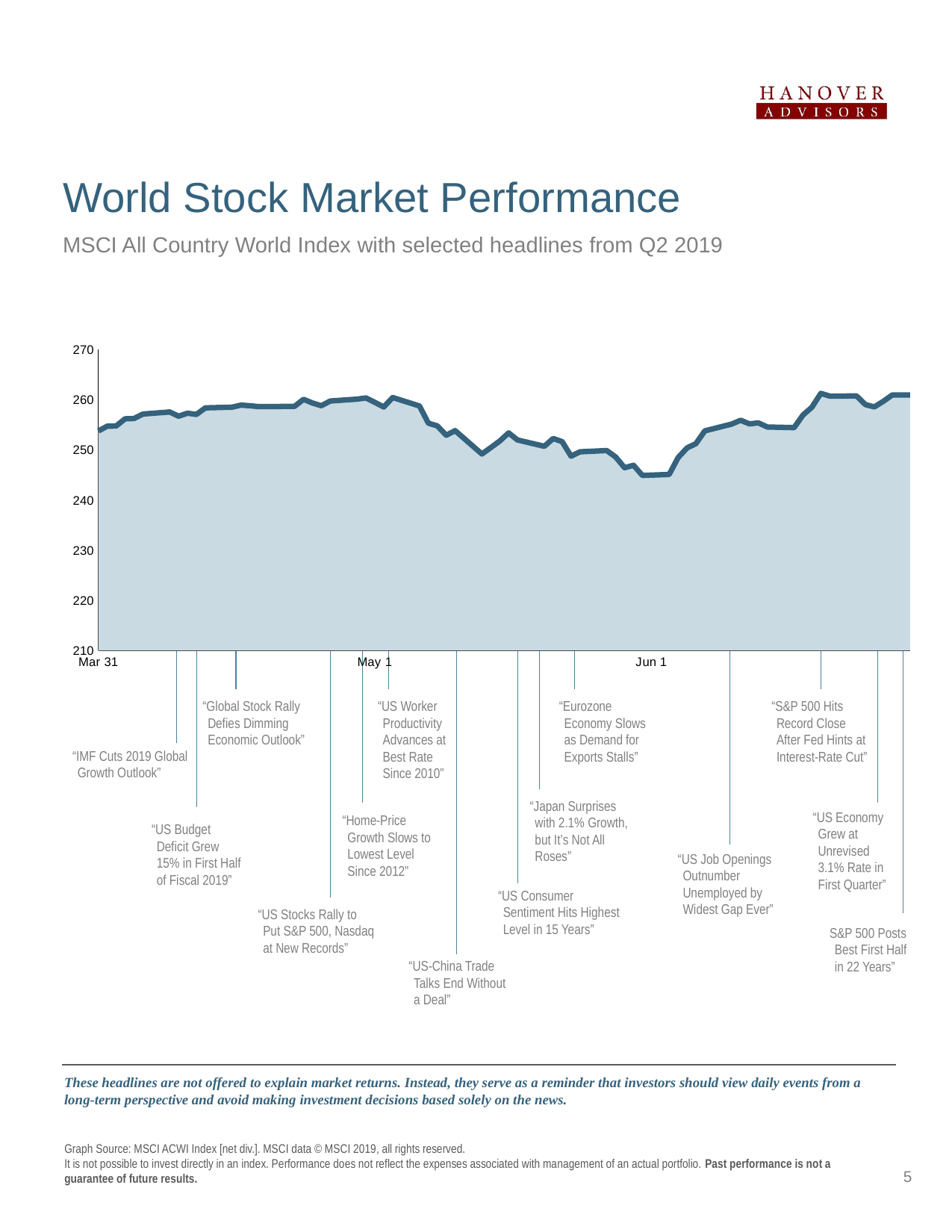
How many date labels are shown along the x axis of the chart? 3 Is the index value at May 1 greater or less than 250? greater Does the index generally rise or fall between early May and Jun 1? fall What kind of chart is shown on the slide? area chart What is the highest value shown on the vertical axis of the chart? 270 Is the index value at Mar 31 greater or less than 260? less Does the index generally rise or fall between Mar 31 and May 1? rise Is the index value around Jun 1 greater or less than 250? less Which is larger, the index value at May 1 or the index value at Jun 1? May 1 What is the title of the slide's chart? World Stock Market Performance